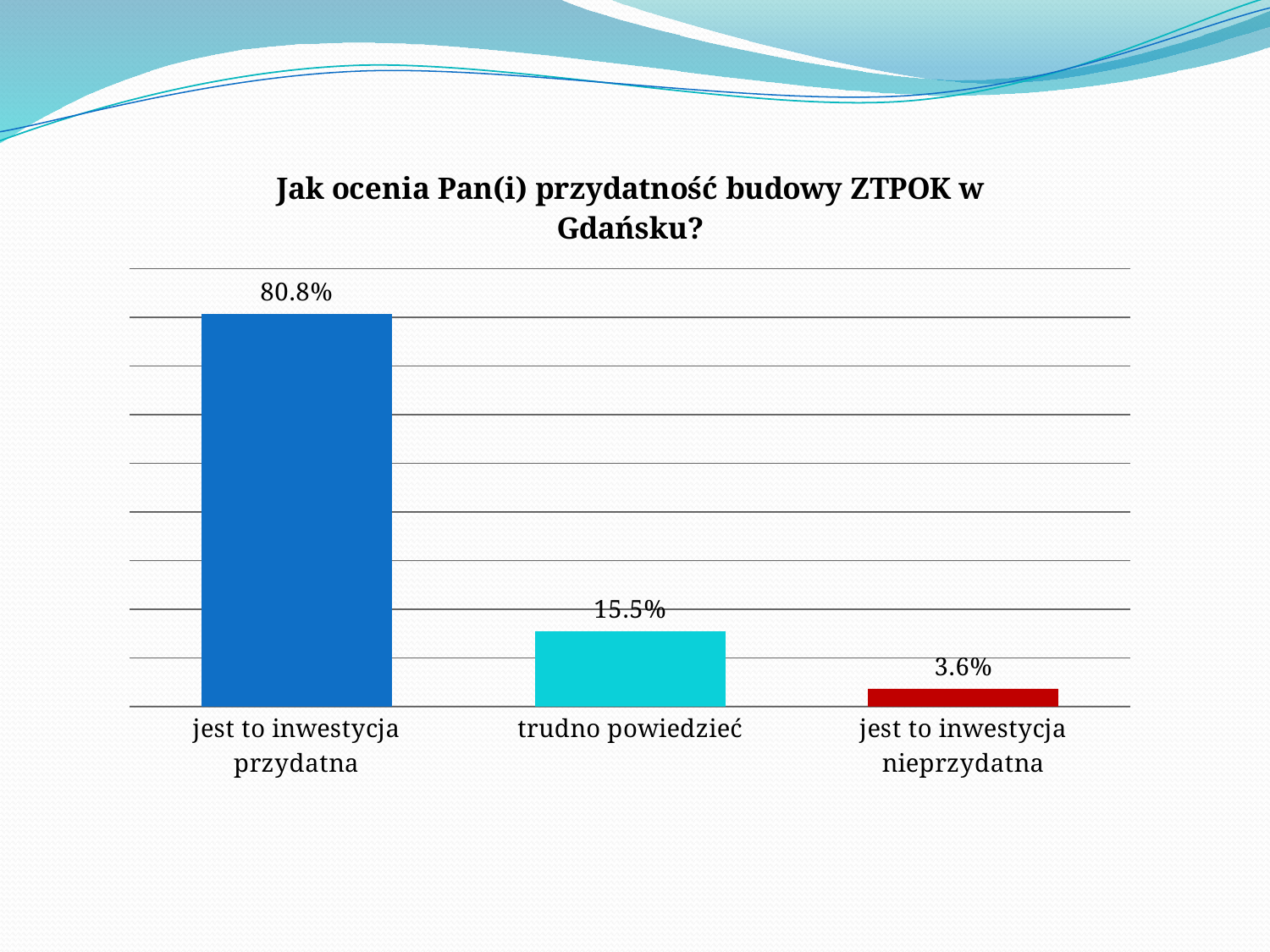
Which category has the lowest value? jest to inwestycja nieprzydatna What is the title of the chart? Jak ocenia Pan(i) przydatność budowy ZTPOK w Gdańsku? What is the value for "trudno powiedzieć"? 15.5% How many categories are shown in the chart? 3 Do the values rise or fall from left to right across the categories? fall Which category has the highest value? jest to inwestycja przydatna What kind of chart is shown on the slide? bar chart What is the value for "jest to inwestycja nieprzydatna"? 3.6% What is the difference between the values for "trudno powiedzieć" and "jest to inwestycja nieprzydatna"? 11.9% What is the value for "jest to inwestycja przydatna"? 80.8% What is the difference between the values for "jest to inwestycja przydatna" and "trudno powiedzieć"? 65.3% Which is larger, the value for "trudno powiedzieć" or the value for "jest to inwestycja nieprzydatna"? trudno powiedzieć